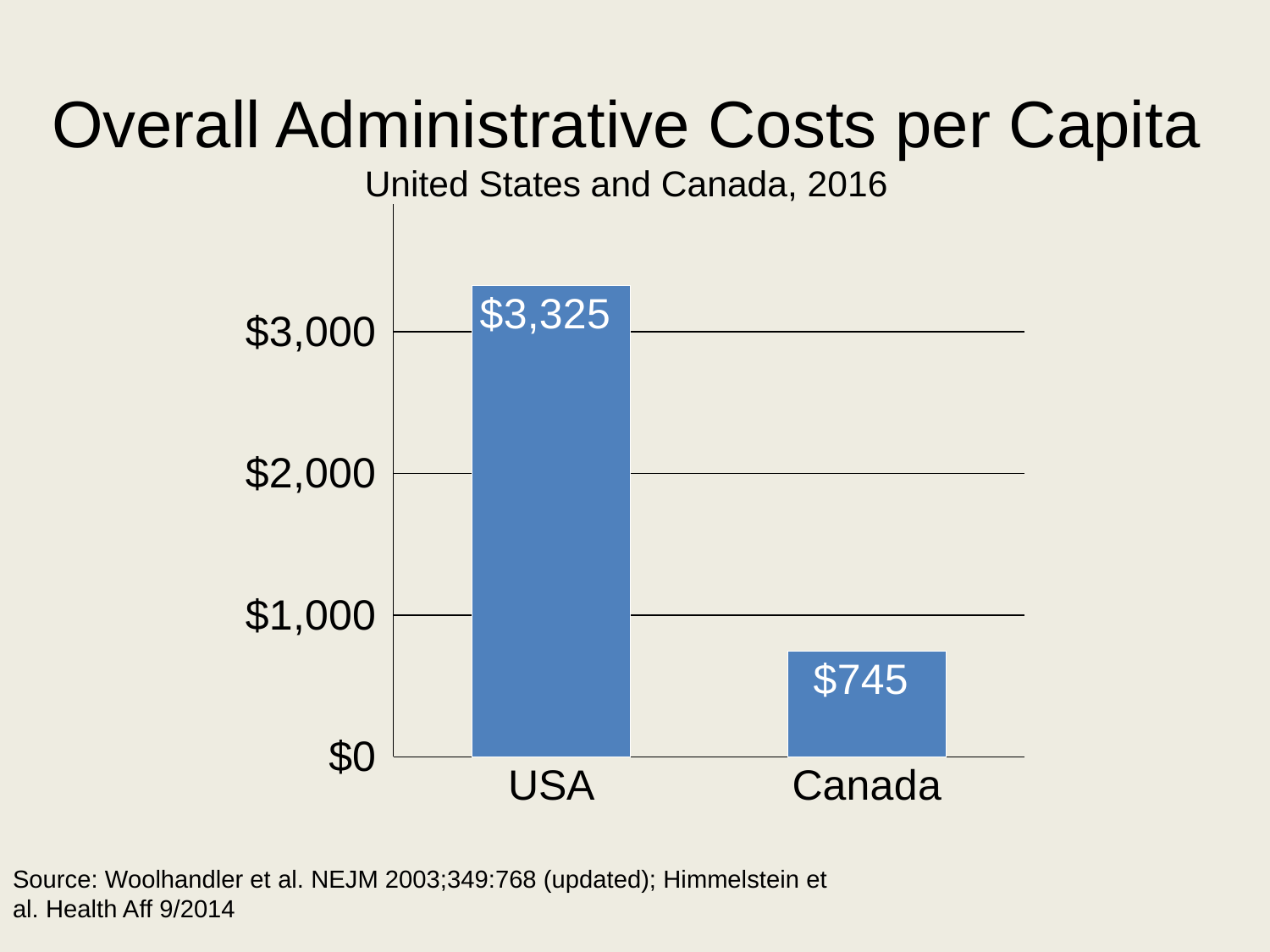
What is the title of the chart? Overall Administrative Costs per Capita Is the value for the USA larger or smaller than the value for Canada? larger Is the value for the USA greater or less than $3,000? greater How much higher is the USA's administrative cost per capita than Canada's? $2,580 Which country has the higher administrative cost per capita? USA What is the overall administrative cost per capita for Canada? $745 What year does the chart's subtitle refer to? 2016 What kind of chart is shown on the slide? bar chart Which country has the lower administrative cost per capita? Canada What is the overall administrative cost per capita for the USA? $3,325 How many countries are shown in the chart? 2 Is the value for Canada greater or less than $1,000? less